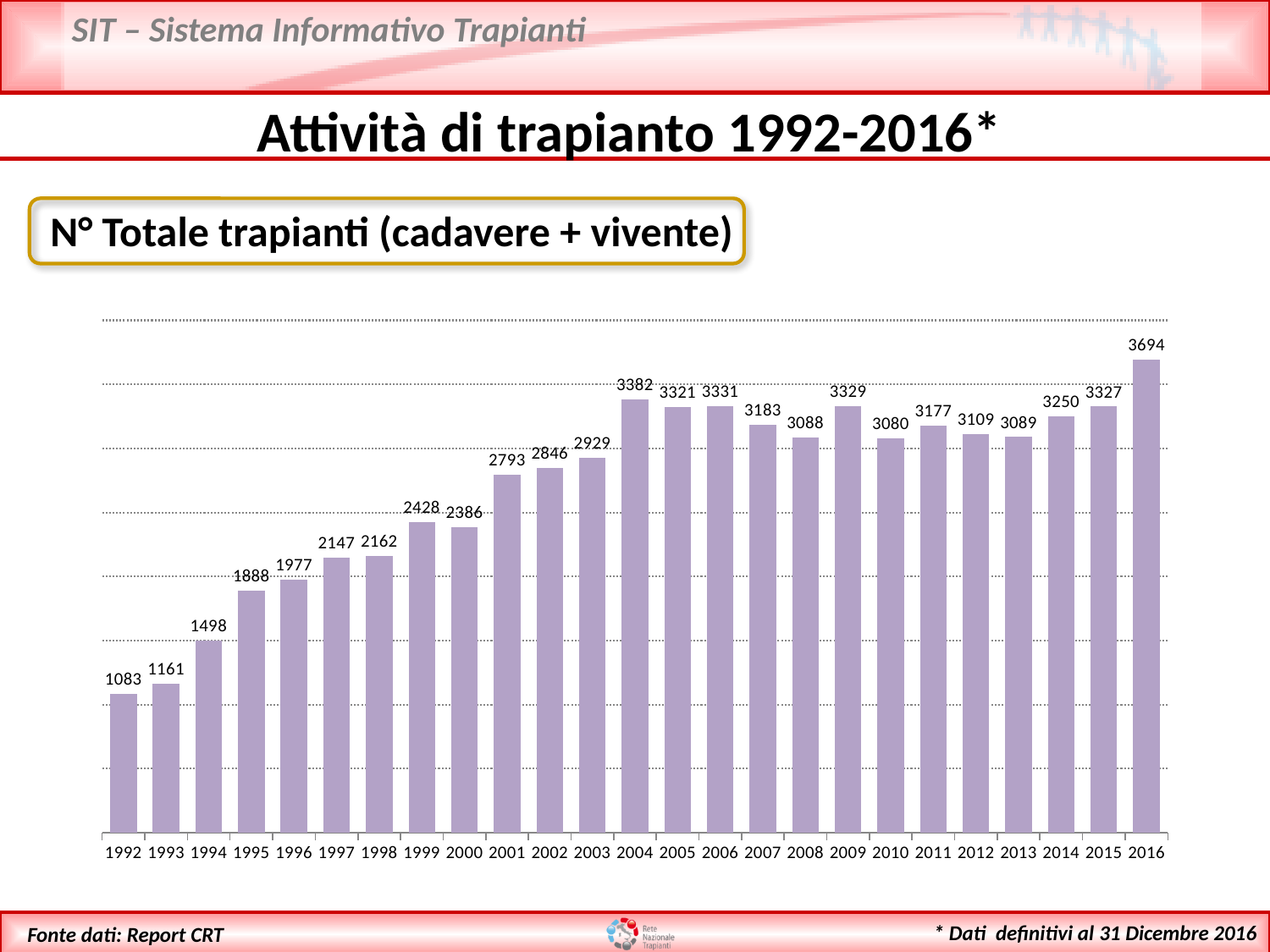
Which year has a larger value, 1998 or 1999? 1999 What is the difference between the values for 1994 and 1993? 337 What kind of chart is shown on the slide? bar chart How many years are shown on the x axis of the chart? 25 What is the value shown for 1992? 1083 What is the total number of transplants shown for 2016? 3694 What is the value shown for 2004? 3382 Which year has a larger value, 2009 or 2010? 2009 What is the difference between the values for 2016 and 2015? 367 Do the values generally rise or fall from 1992 to 2016? rise Which year has the highest number of transplants? 2016 Which year has the lowest number of transplants? 1992